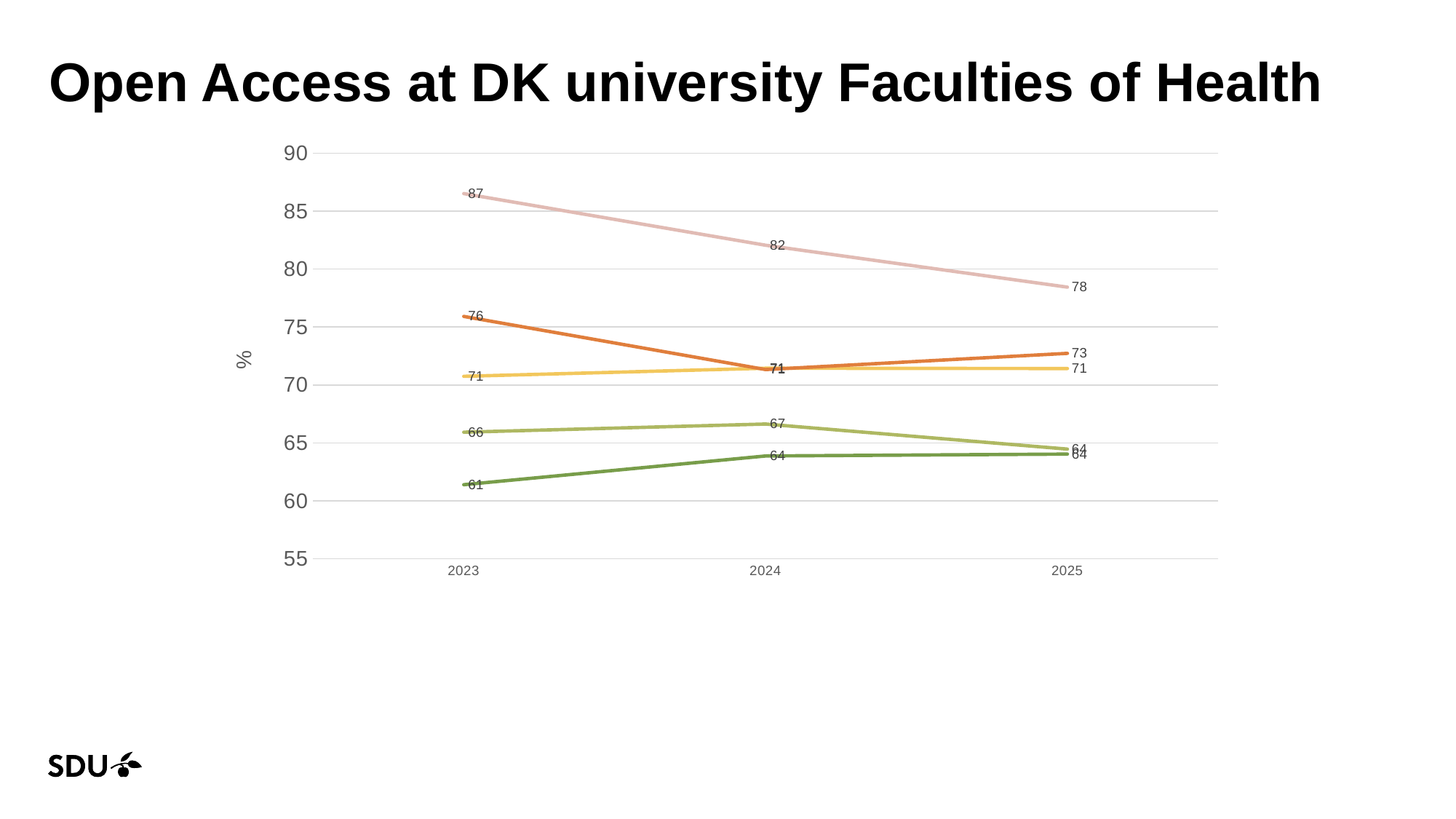
What is the title of the chart on the slide? Open Access at DK university Faculties of Health Does the pink (topmost) line rise or fall from 2023 to 2025? fall By how much did the pink (topmost) line fall from 2023 to 2025? 9 How many lines are plotted on the chart? 5 What is the value of the dark green (lowest) line in 2023? 61 What is the value of the orange line in 2024? 71 Which line has the lowest value in 2023? the dark green line (61) What is the value of the pink (topmost) line in 2023? 87 What is the value of the pink (topmost) line in 2025? 78 Which line has the highest value in 2023? the pink line (87) What kind of chart is shown on the slide? line chart How many years are shown on the x axis of the chart? 3